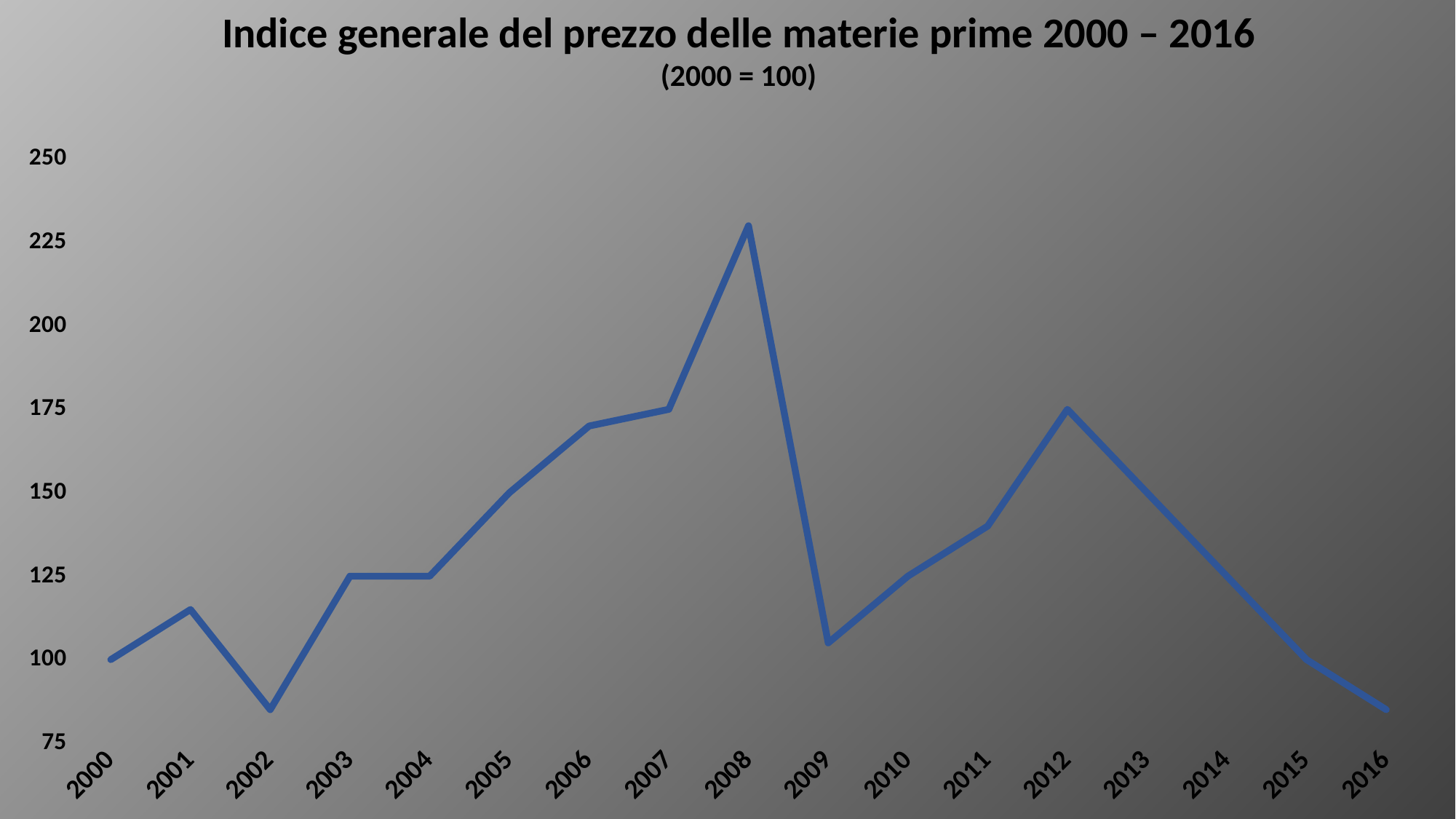
Which year has the highest index value? 2008 How many years are plotted on the x axis? 17 Is the value for 2008 greater or less than 200? greater What is the index value for 2000? 100 Which is larger, the value for 2007 or the value for 2011? 2007 Is the value for 2016 greater or less than 100? less What is the title of the chart? Indice generale del prezzo delle materie prime 2000 – 2016 What kind of chart is shown on the slide? line chart Is the value for 2006 greater or less than 150? greater Which is larger, the value for 2008 or the value for 2012? 2008 Do the values rise or fall from 2012 to 2016? fall